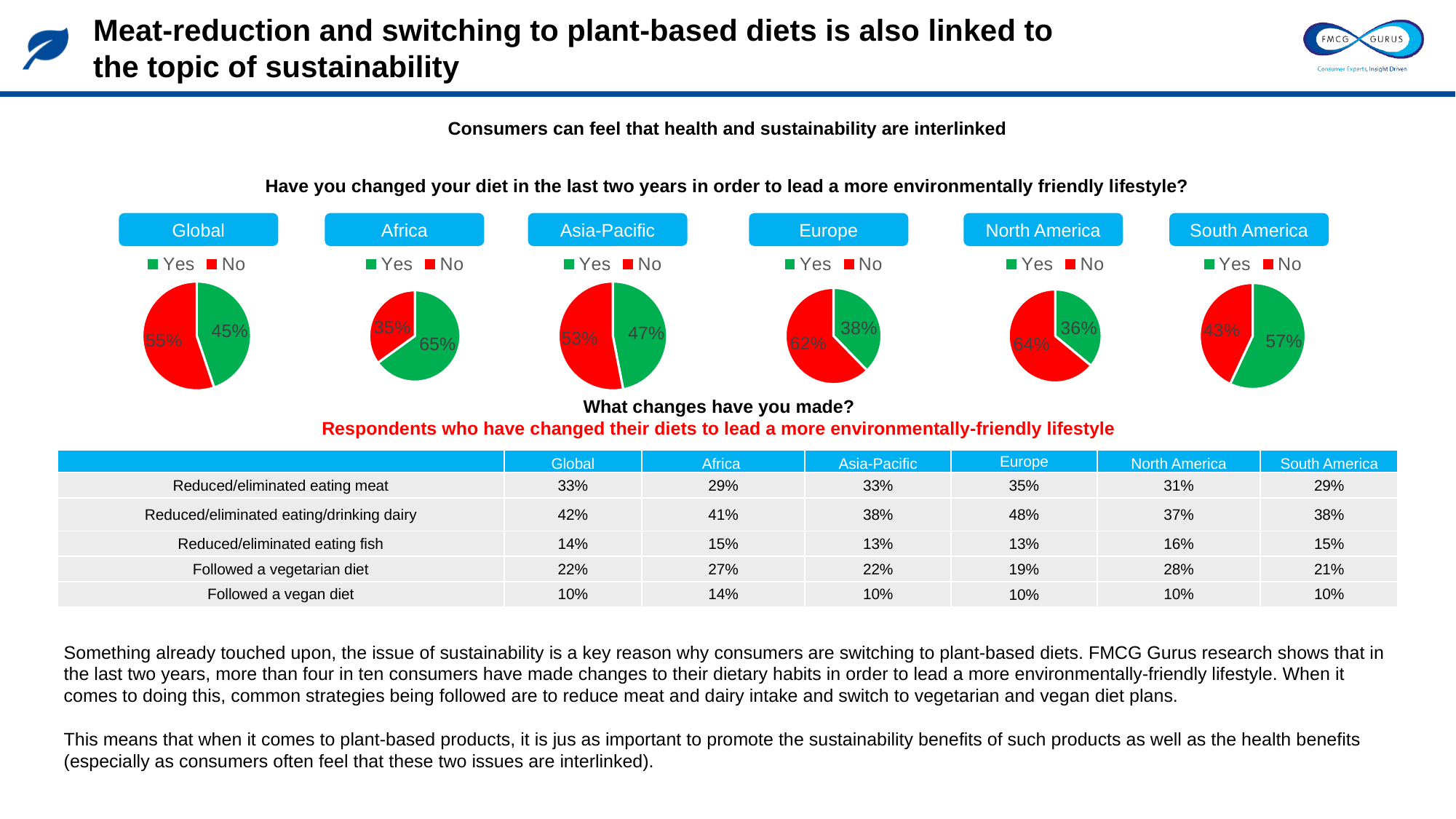
In the Europe pie chart, what percentage of respondents answered Yes? 38% Is the Yes share larger in the Europe pie chart or in the South America pie chart? South America In the North America pie chart, what percentage of respondents answered No? 64% In the Asia-Pacific pie chart, what is the difference between the No share and the Yes share? 6% In the South America pie chart, what percentage of respondents answered Yes? 57% Across the six pie charts, which region has the highest share of respondents answering Yes? Africa What type of chart is used to show the answers to 'Have you changed your diet in the last two years in order to lead a more environmentally friendly lifestyle?' Pie chart In the Africa pie chart, what percentage of respondents answered No? 35% How many series does the legend of each pie chart list? 2 Across the six pie charts, which region has the lowest share of respondents answering Yes? North America How many pie charts are shown on the slide? 6 In the Global pie chart, what percentage of respondents answered Yes? 45%